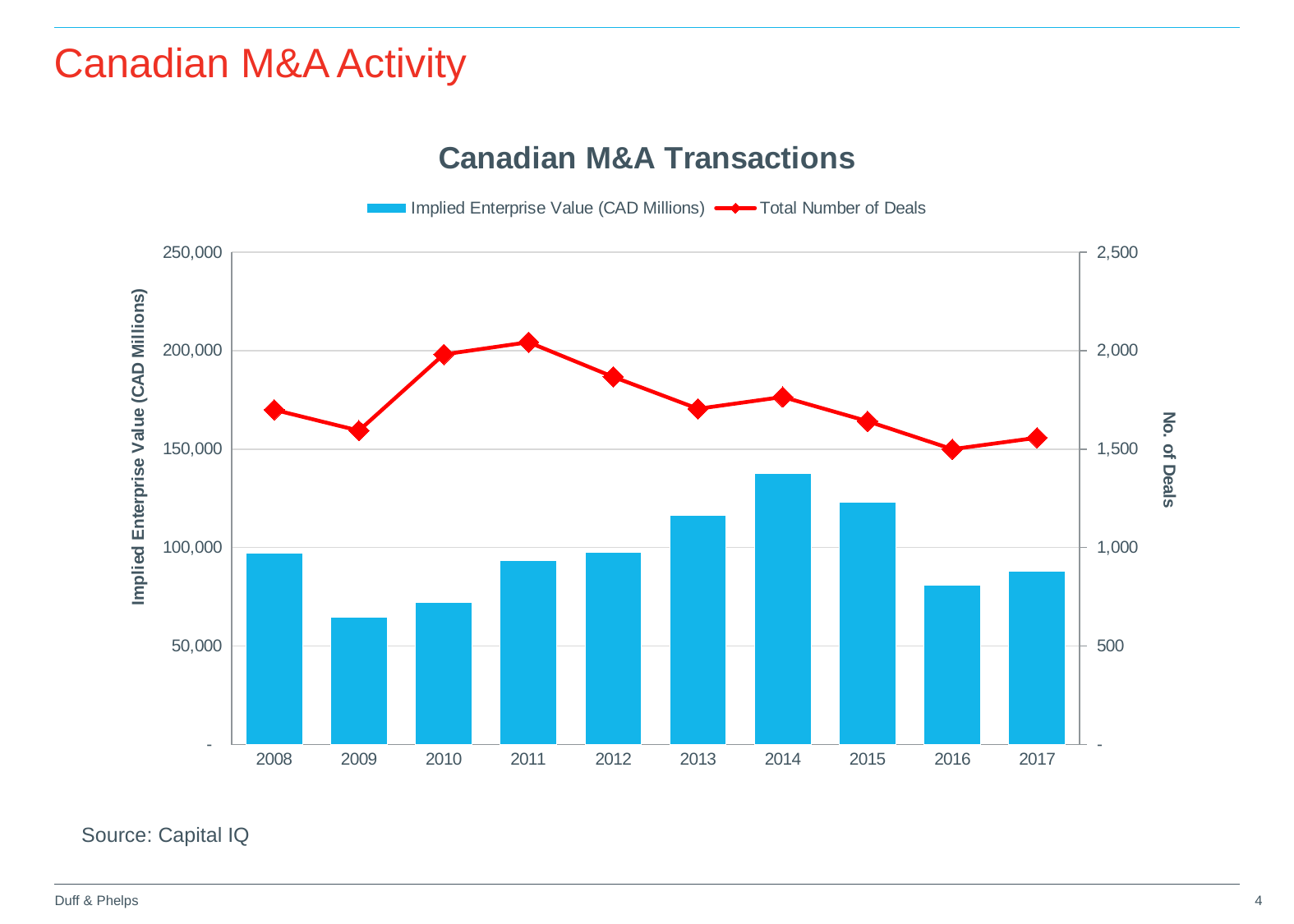
What is the title of the chart? Canadian M&A Transactions What kind of chart is this? Combination bar and line chart Which year has the highest Total Number of Deals? 2011 Is the Total Number of Deals for 2011 greater or less than 2,000? greater Is the Implied Enterprise Value for 2014 greater or less than 100,000? greater Which year has the lowest Implied Enterprise Value (CAD Millions)? 2009 Which year has the larger Implied Enterprise Value, 2014 or 2015? 2014 How many years are shown on the x axis? 10 How many series does the legend list? 2 Which year has the highest Implied Enterprise Value (CAD Millions)? 2014 Is the Implied Enterprise Value for 2009 greater or less than 100,000? less Does the Total Number of Deals rise or fall from 2011 to 2016? fall